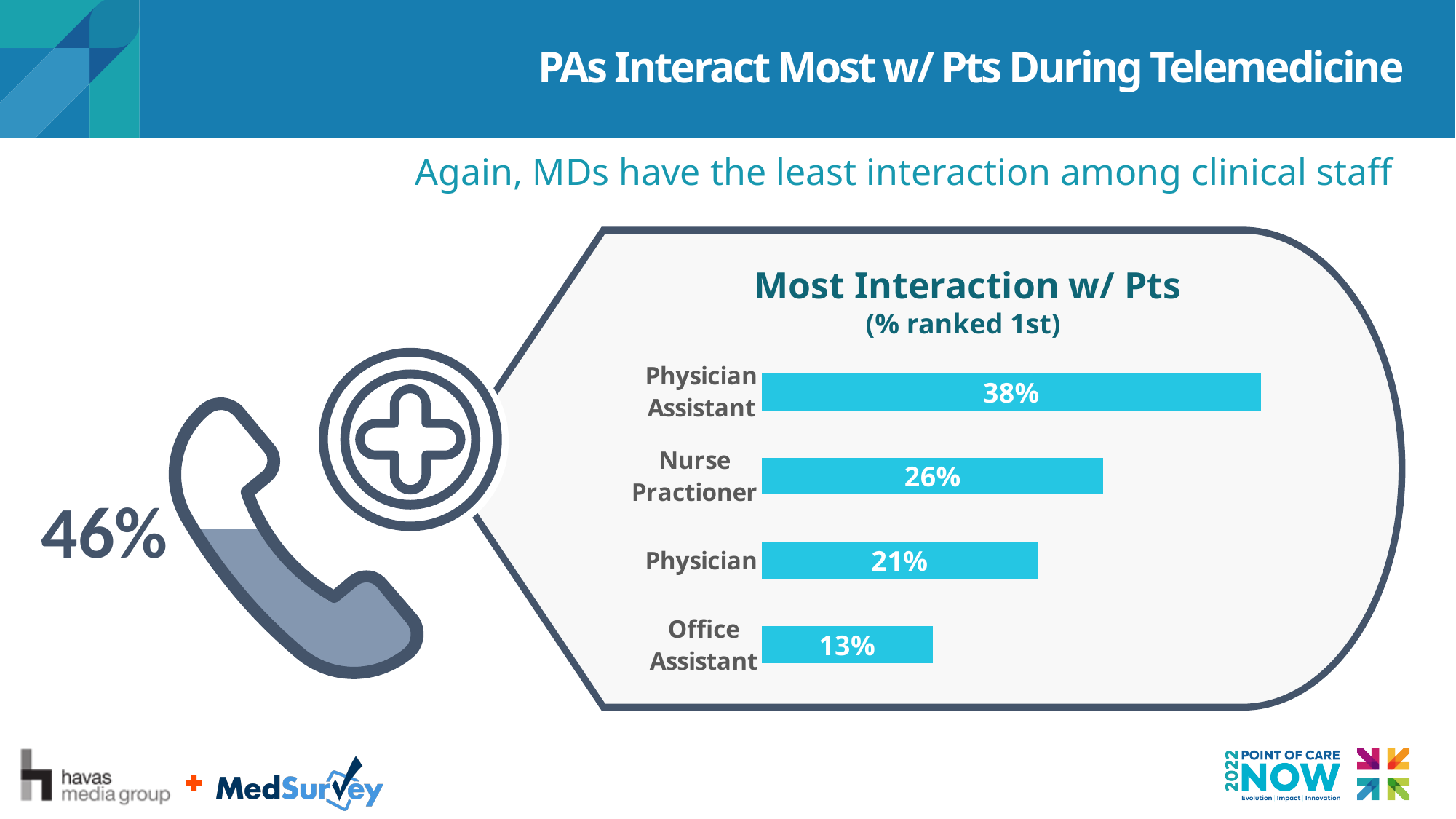
What is the value shown for Office Assistant? 13% How many categories are shown in the chart? 4 Which category has the highest value in the chart? Physician Assistant What is the value shown for Physician? 21% Which category has the lowest value in the chart? Office Assistant Which is larger, the value for Nurse Practioner or the value for Physician? Nurse Practioner What is the difference between the Physician Assistant and Physician values? 17% What is the title of the chart? Most Interaction w/ Pts (% ranked 1st) What is the difference between the Nurse Practioner and Office Assistant values? 13% What percentage ranked Physician Assistant 1st for most interaction with patients? 38% What kind of chart is shown on the slide? Bar chart What is the value shown for Nurse Practioner? 26%